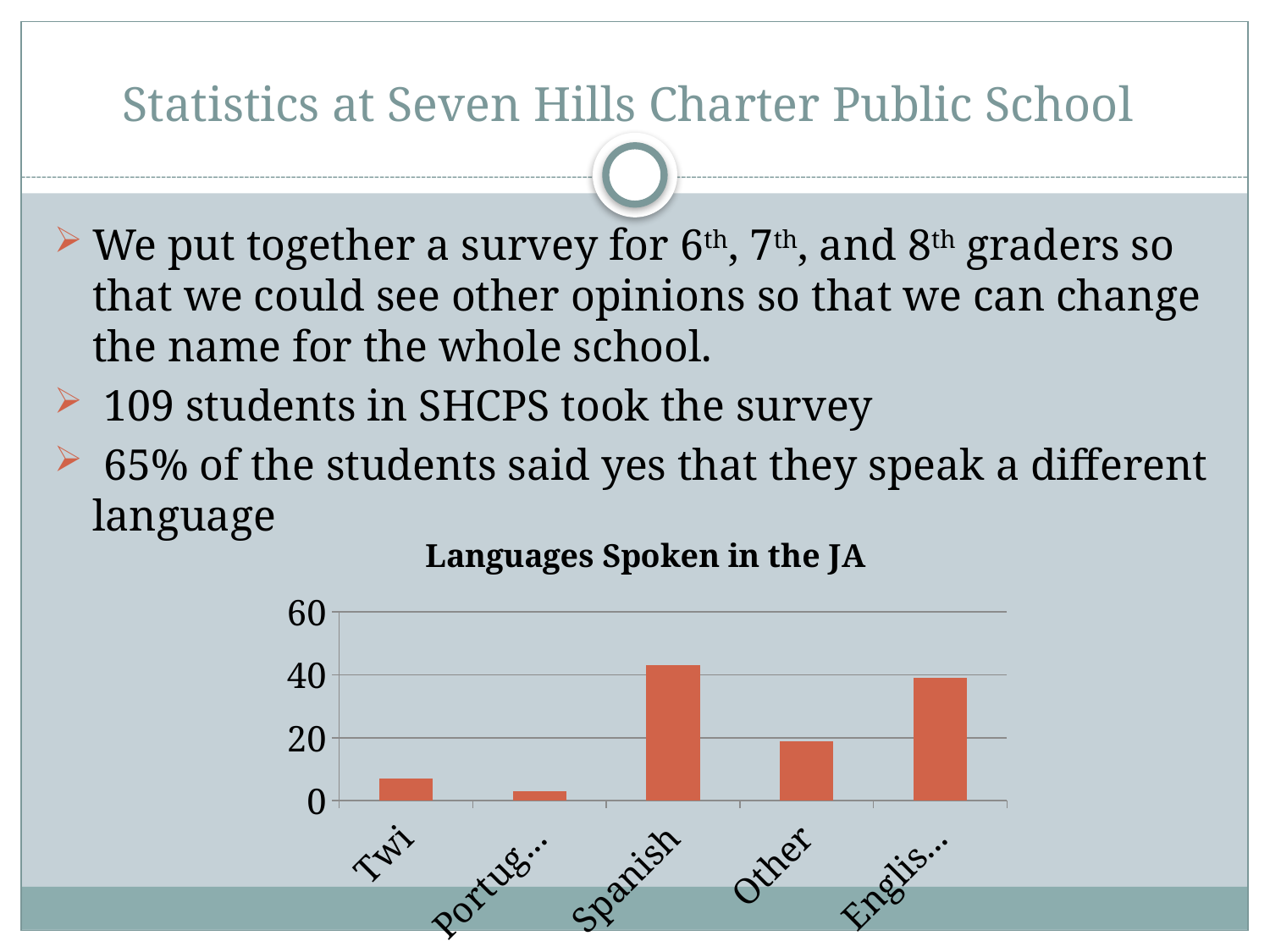
Which category has the lowest bar in the chart? Portug... Which is larger, the value for Twi or the value for Other? Other What is the highest value shown on the y axis of the chart? 60 Is the value for Twi greater or less than 20? less Is the value for the category labelled 'Englis...' greater or less than 20? greater How many language categories are shown on the x axis of the chart? 5 Is the value for Other greater or less than 40? less Which is larger, the value for Spanish or the value for Other? Spanish What is the title of the chart? Languages Spoken in the JA Which language has the highest bar in the chart? Spanish What kind of chart is shown on the slide? bar chart